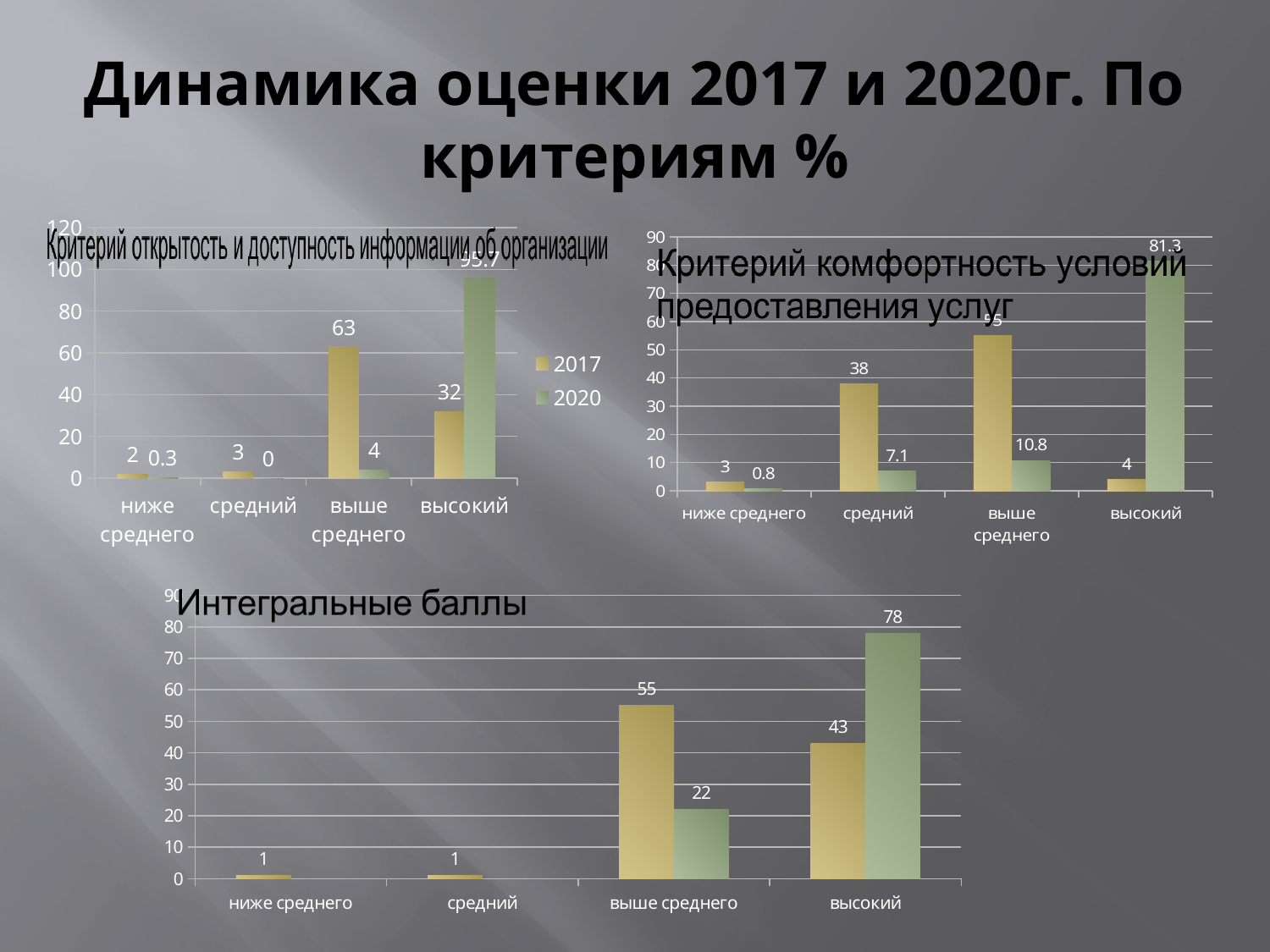
In the chart 'Интегральные баллы', what is the value of the green (2020) bar for 'высокий'? 78 In the chart 'Критерий открытость и доступность информации об организации', what is the 2020 value for 'ниже среднего'? 0.3 In the chart 'Критерий комфортность условий предоставления услуг', what is the 2017 value for 'средний'? 38 In the chart 'Критерий открытость и доступность информации об организации', what is the difference between the 2017 values for 'выше среднего' and 'высокий'? 31 In the chart 'Критерий открытость и доступность информации об организации', what is the 2017 value for 'выше среднего'? 63 In the chart 'Интегральные баллы', what is the difference between the gold (2017) and green (2020) bars for 'выше среднего'? 33 In the chart 'Критерий комфортность условий предоставления услуг', what is the 2020 value for 'высокий'? 81.3 In the chart 'Интегральные баллы', how many categories are shown on the x axis? 4 In the chart 'Критерий открытость и доступность информации об организации', which series does the legend list besides 2017? 2020 What type of chart is 'Интегральные баллы'? bar chart In the chart 'Критерий комфортность условий предоставления услуг', which category has the lowest 2020 value? ниже среднего In the chart 'Критерий комфортность условий предоставления услуг', is the 2017 value for 'выше среднего' greater or less than 50? greater